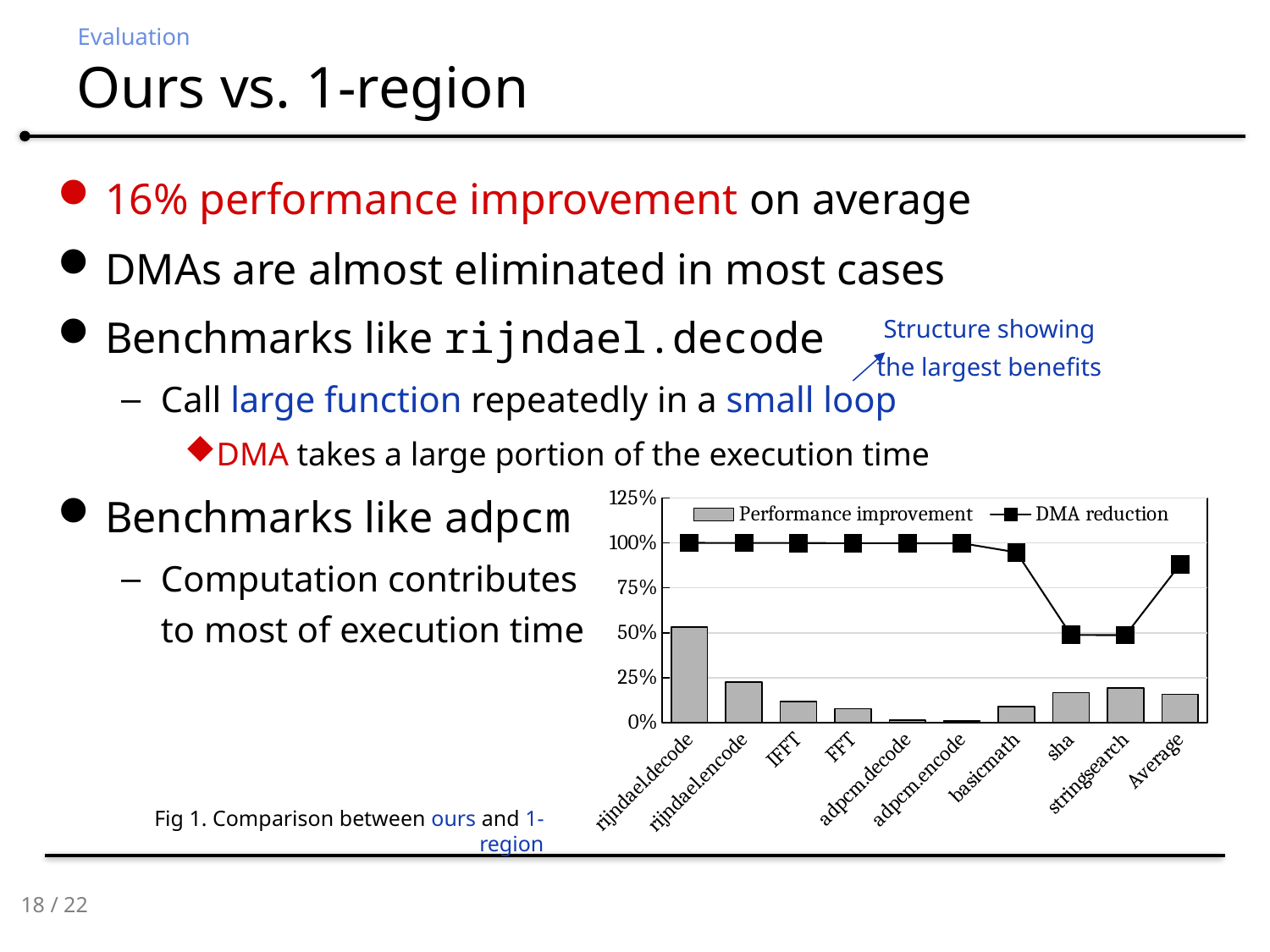
Which has the larger performance improvement, IFFT or adpcm.decode? IFFT Is the performance improvement for rijndael.encode greater or less than 25%? less Which benchmark has the highest performance improvement bar? rijndael.decode How many series does the chart's legend list? 2 Which has the larger DMA reduction, basicmath or stringsearch? basicmath Is the performance improvement for rijndael.decode greater or less than 25%? greater Is the DMA reduction for Average greater or less than 75%? greater How many benchmark categories are shown on the x axis of the chart? 10 What are the two series named in the chart's legend? Performance improvement and DMA reduction Which series in the chart is drawn as bars? Performance improvement